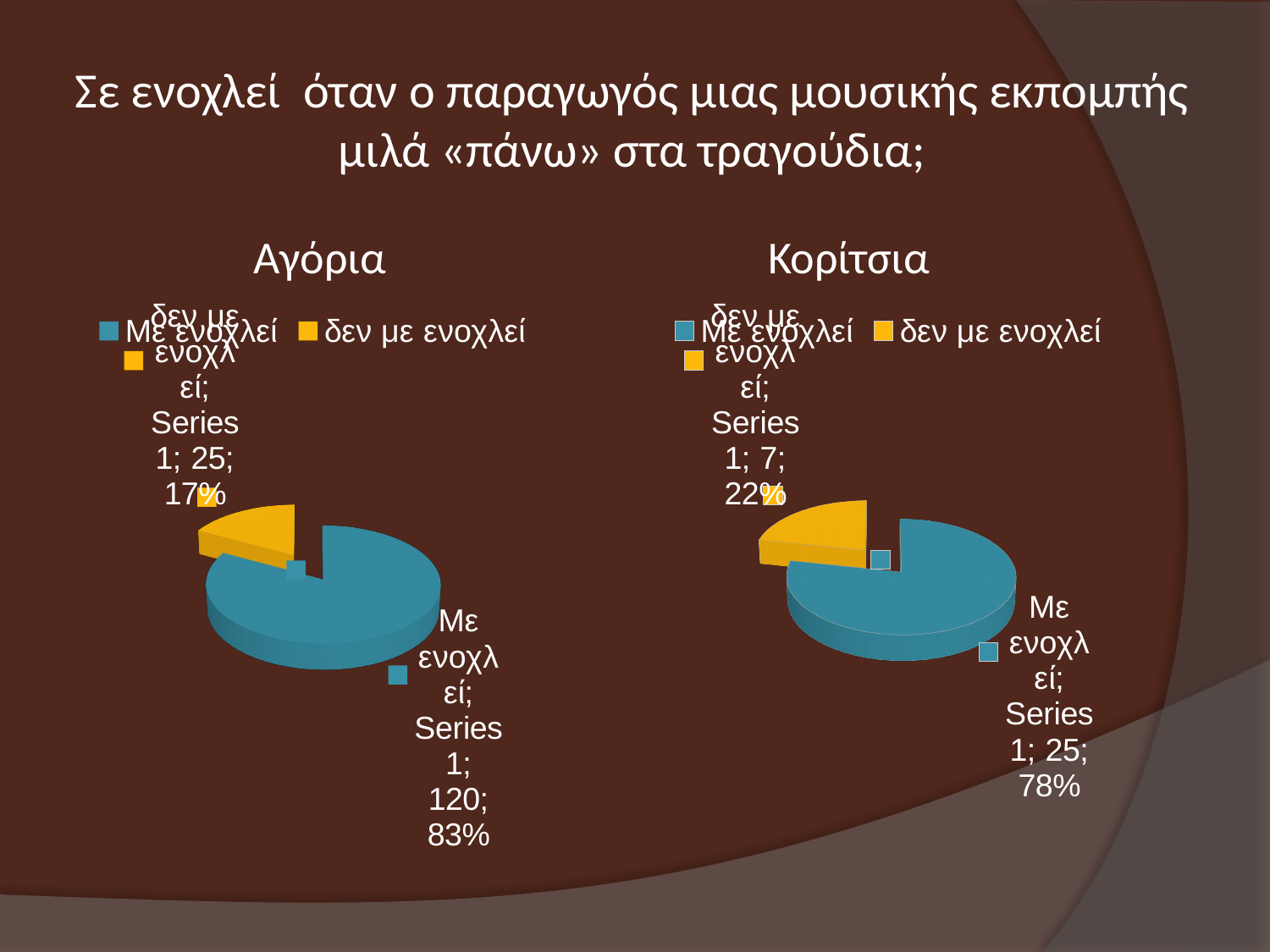
In the Αγόρια chart, what is the difference between the values for Με ενοχλεί and δεν με ενοχλεί? 95 Which is larger: the value for Με ενοχλεί in the Αγόρια chart or the value for Με ενοχλεί in the Κορίτσια chart? Αγόρια In the Κορίτσια chart, what colour is the Με ενοχλεί slice? Blue In the Αγόρια chart, what percentage share does δεν με ενοχλεί have? 17% What type of chart is the Κορίτσια chart? Pie chart In the Κορίτσια chart, what is the difference between the values for Με ενοχλεί and δεν με ενοχλεί? 18 In the Κορίτσια chart, which category has the smallest slice? δεν με ενοχλεί In the Κορίτσια chart, what percentage share does Με ενοχλεί have? 78% In the Αγόρια chart, which category has the largest slice? Με ενοχλεί In the Κορίτσια chart, what is the value for δεν με ενοχλεί? 7 In the Αγόρια chart, what is the value for Με ενοχλεί? 120 How many categories does the Αγόρια chart show? 2